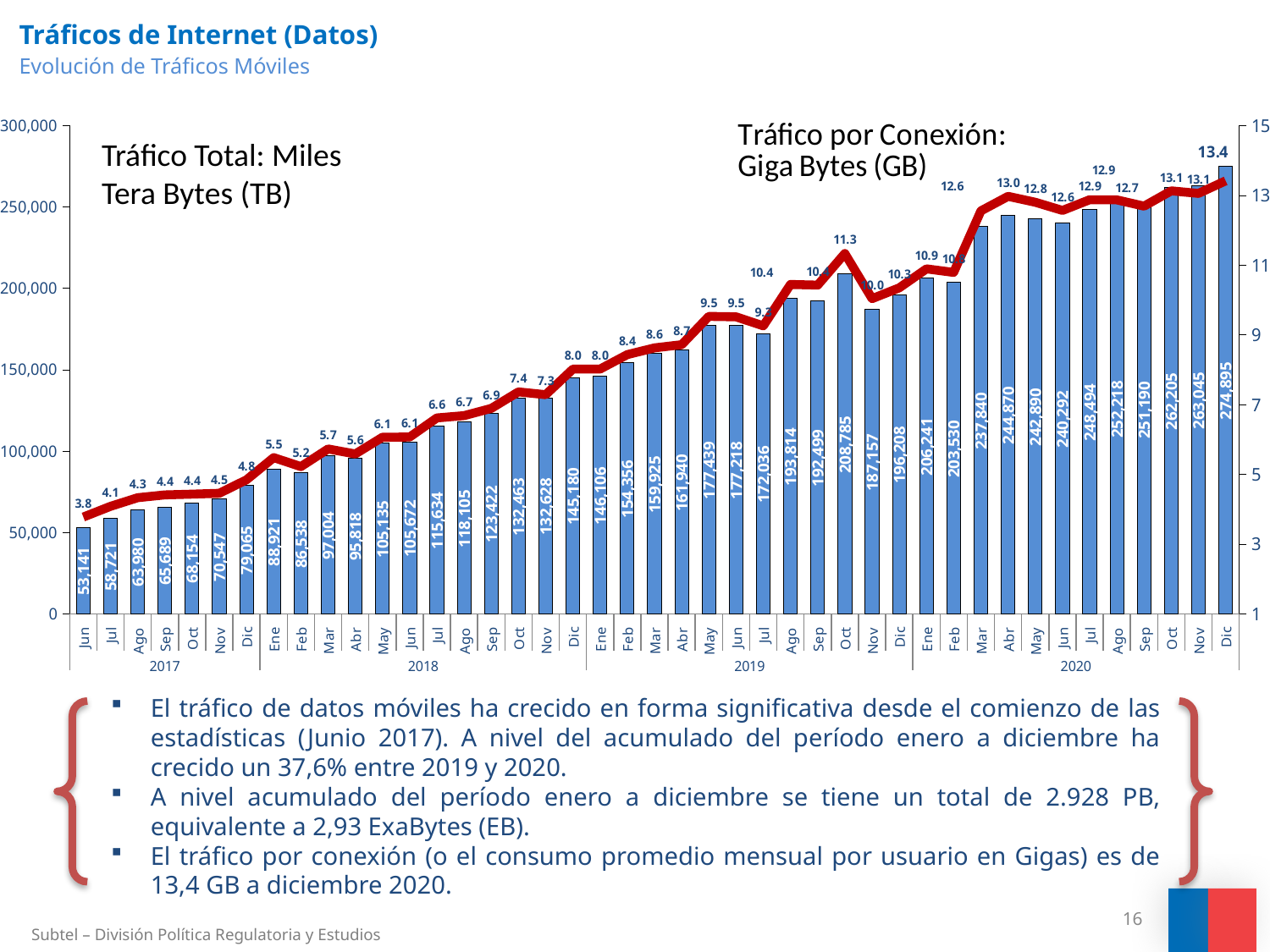
Which month has the lowest total traffic bar? Jun 2017 What is the total mobile traffic (Tráfico Total) value for Jun 2017? 53,141 What is the difference in total traffic between Dic 2020 and Dic 2019? 78,687 What is the Tráfico por Conexión (GB) value for Jun 2017? 3.8 Which month has the larger total traffic bar, Oct 2019 or Nov 2019? Oct 2019 What is the total mobile traffic (Tráfico Total) value for Dic 2020? 274,895 What is the difference in Tráfico por Conexión between Dic 2020 and Jun 2017? 9.6 Do the total traffic bars generally rise or fall from Jun 2017 to Dic 2020? Rise What kind of chart is shown on the slide? Combined bar and line chart What is the Tráfico por Conexión (GB) value for Dic 2020? 13.4 Which month has the highest total traffic bar? Dic 2020 How many monthly bars are plotted in the chart? 43